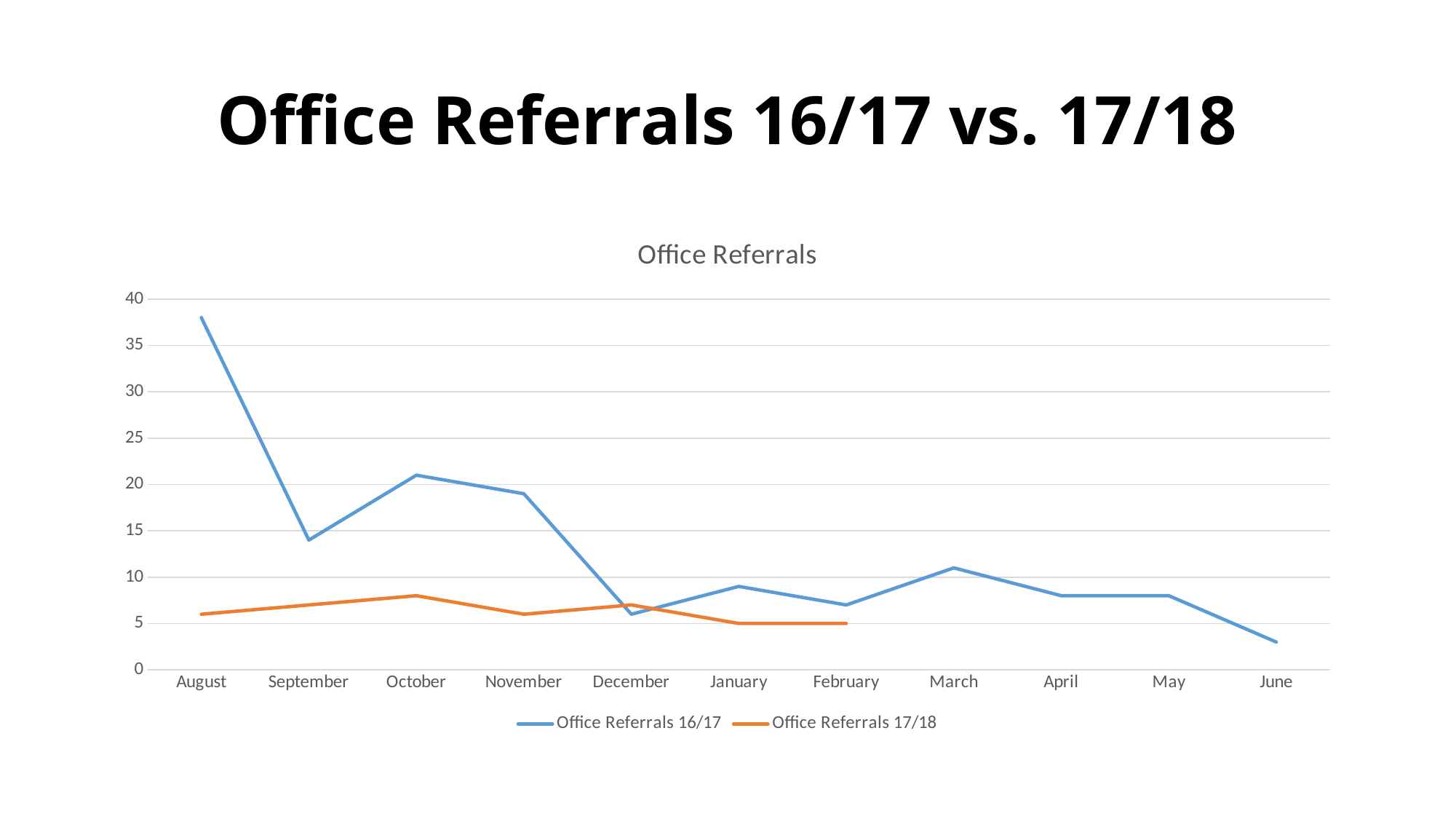
Is the Office Referrals 16/17 value for June greater or less than 5? less How many months are shown on the x axis? 11 Which is larger in August: Office Referrals 16/17 or Office Referrals 17/18? Office Referrals 16/17 Is the Office Referrals 16/17 value for October greater or less than 20? greater Is the Office Referrals 16/17 value for August greater or less than 35? greater Which series is drawn in orange? Office Referrals 17/18 How many series does the legend list? 2 In which month is the Office Referrals 16/17 value lowest? June In which month is the Office Referrals 16/17 value highest? August Does the Office Referrals 16/17 line generally rise or fall from August to June? fall What kind of chart is shown on the slide? line chart